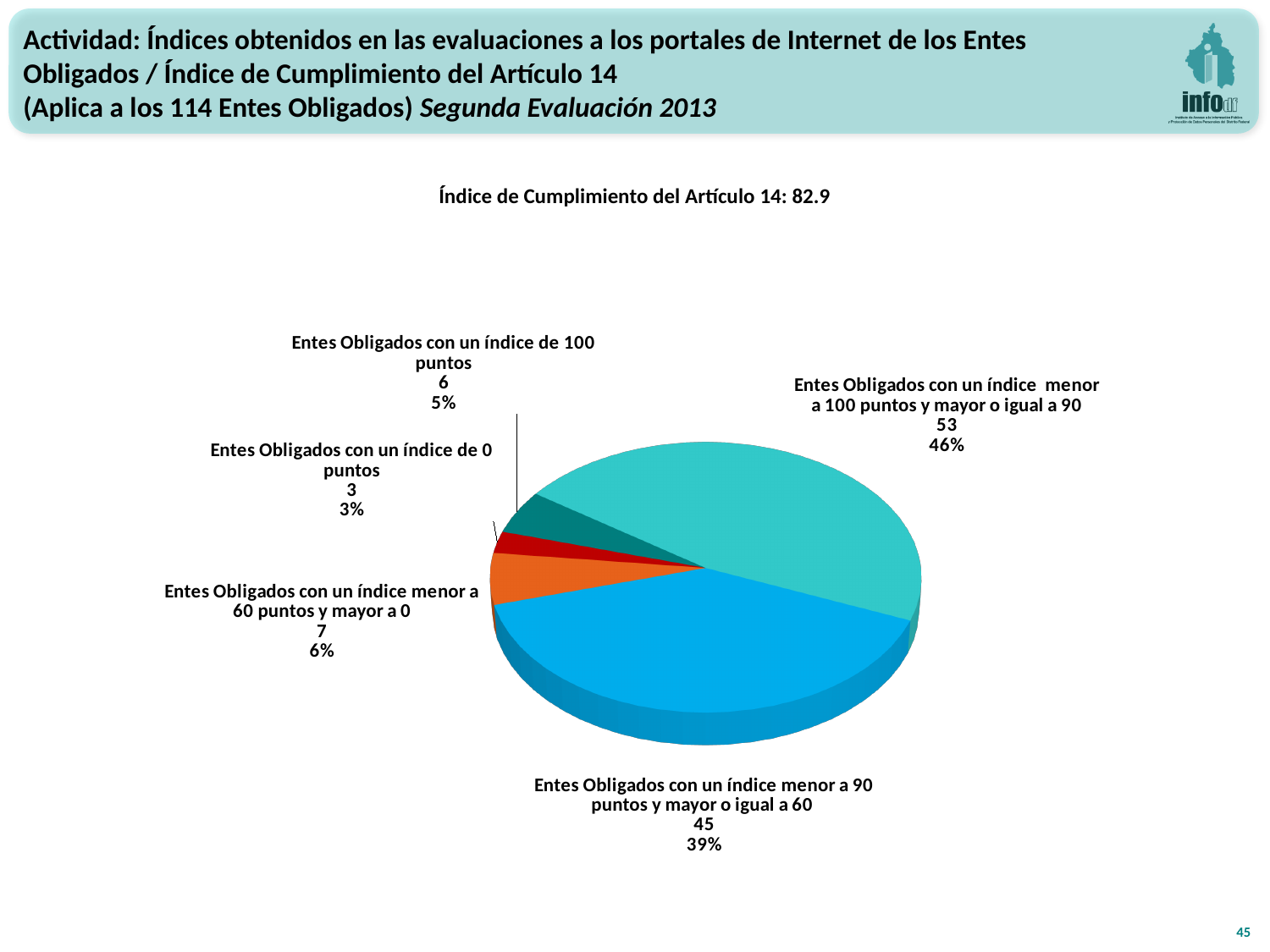
How many categories does the pie chart have? 5 Which is larger: the number of Entes Obligados with an index of 100 points or the number with an index less than 60 points and greater than 0? Entes Obligados con un índice menor a 60 puntos y mayor a 0 Which category has the largest slice of the pie? Entes Obligados con un índice menor a 100 puntos y mayor o igual a 90 What share of the pie is for Entes Obligados with an index of 0 points? 3% What kind of chart is shown on the slide? Pie chart How many Entes Obligados have an index of 100 points? 6 Which category has the smallest slice of the pie? Entes Obligados con un índice de 0 puntos How many Entes Obligados have an index less than 90 points and greater than or equal to 60? 45 What is the Índice de Cumplimiento del Artículo 14 stated above the chart? 82.9 How many Entes Obligados have an index less than 60 points and greater than 0? 7 What percentage of the pie corresponds to Entes Obligados with an index less than 100 points and greater than or equal to 90? 46% What is the difference in count between Entes Obligados with an index less than 100 and greater than or equal to 90, and those with an index less than 90 and greater than or equal to 60? 8